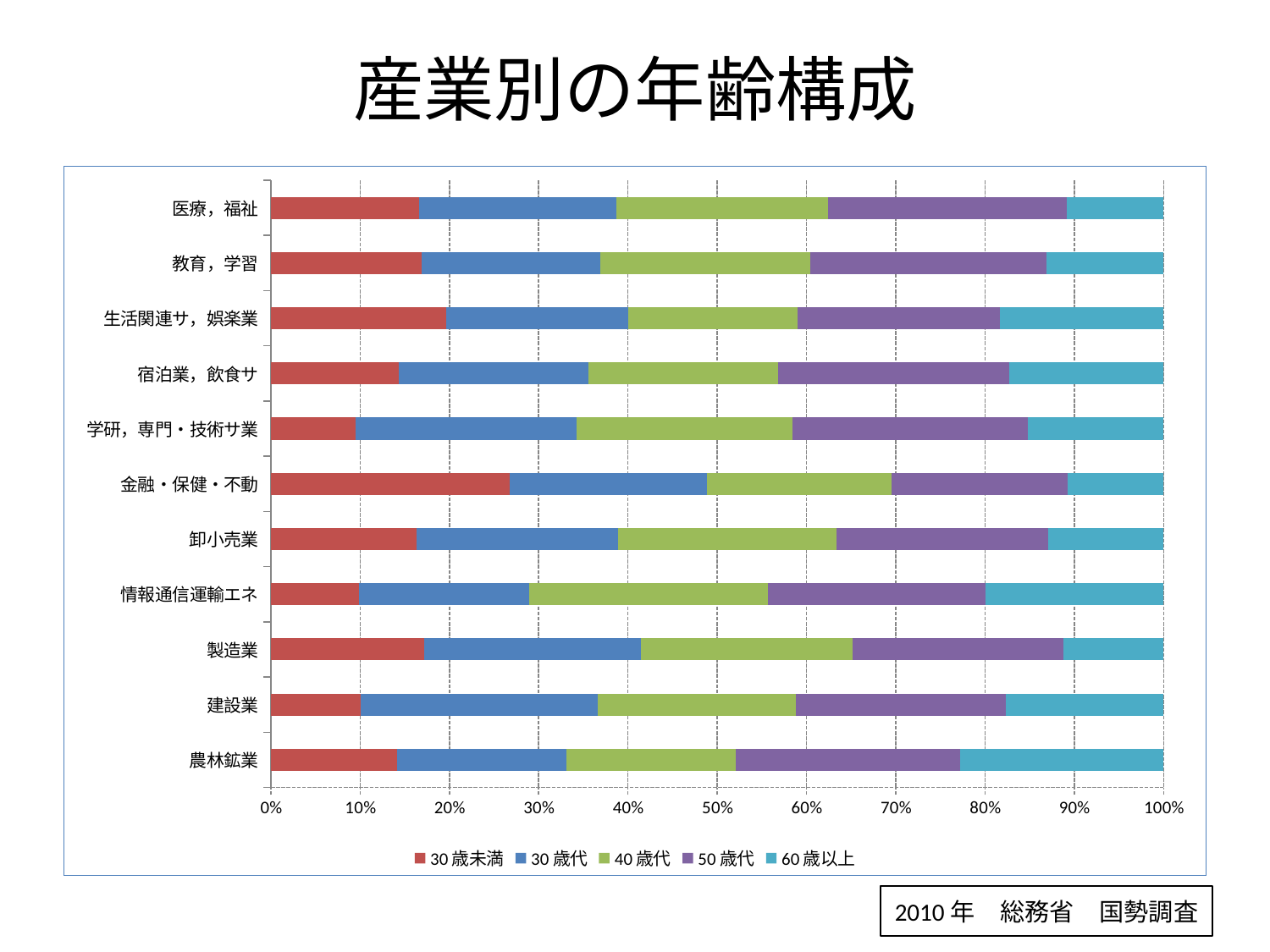
Which industry has the largest share of 60歳以上? 農林鉱業 What is the total of the stacked bar for 製造業? 100% Is the 30歳未満 share for 医療，福祉 greater or less than 10%? greater Which industry has the largest share of 30歳未満? 金融・保健・不動 How many series does the legend list? 5 How many industry categories are plotted on the chart? 11 Is the 30歳未満 share for 金融・保健・不動 greater or less than 20%? greater What kind of chart is shown on the slide? Stacked bar chart Is the 60歳以上 share for 農林鉱業 greater or less than 20%? greater Which has the larger 60歳以上 share, 農林鉱業 or 医療，福祉? 農林鉱業 Which has the larger 30歳未満 share, 金融・保健・不動 or 農林鉱業? 金融・保健・不動 What is the title of the chart on the slide? 産業別の年齢構成